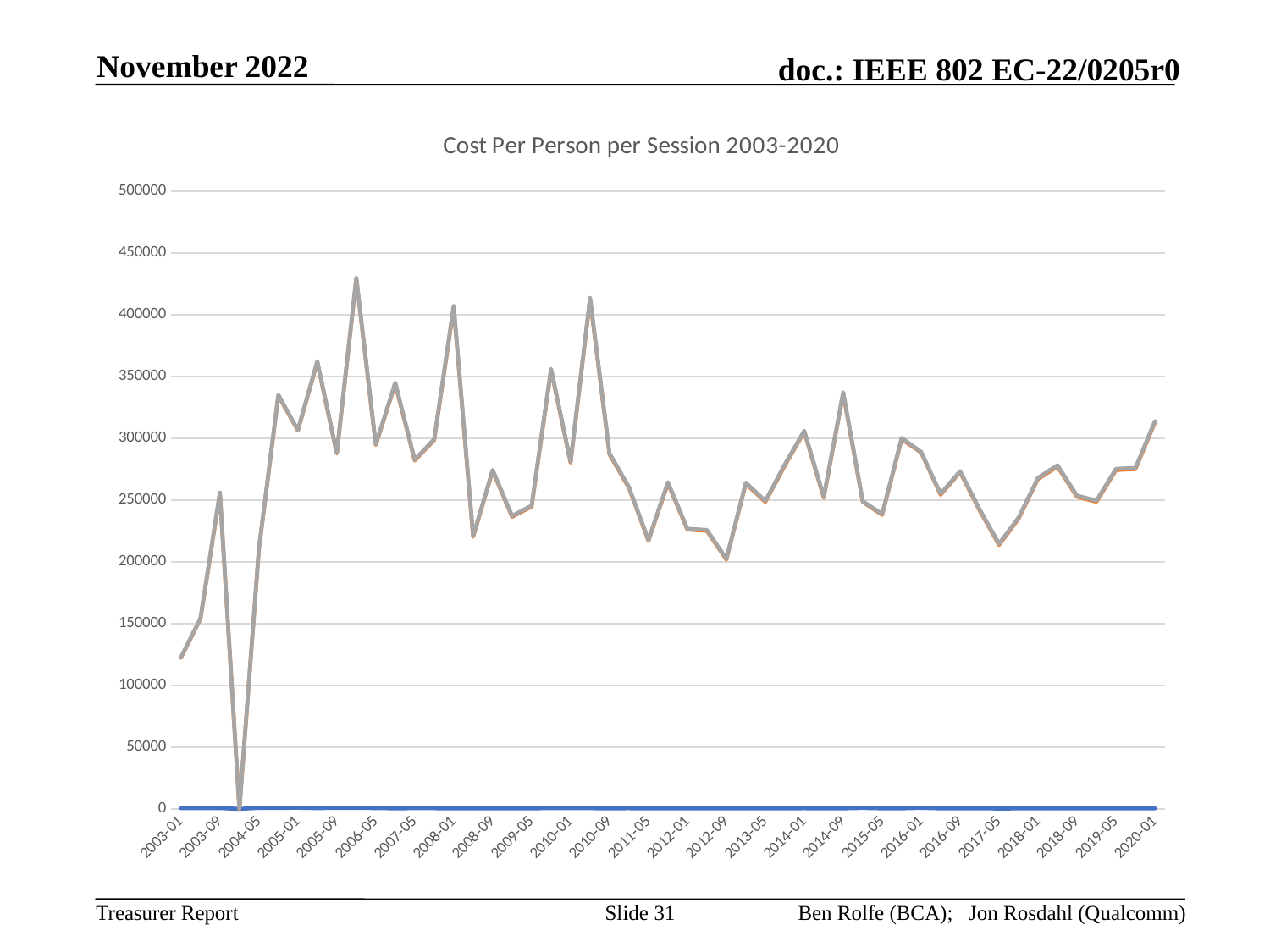
Is the value of the gray line at 2004-05 greater or less than 50000? greater Is the value of the gray line at 2010-09 greater or less than 300000? less Does the gray line rise or fall between 2016-01 and 2017-05? fall Is the value of the gray line at 2020-01 greater or less than 300000? greater What is the title of the chart? Cost Per Person per Session 2003-2020 Which is larger, the gray line's value at 2003-01 or at 2005-01? 2005-01 What is the highest value shown on the y axis? 500000 What kind of chart is shown on the slide? line chart